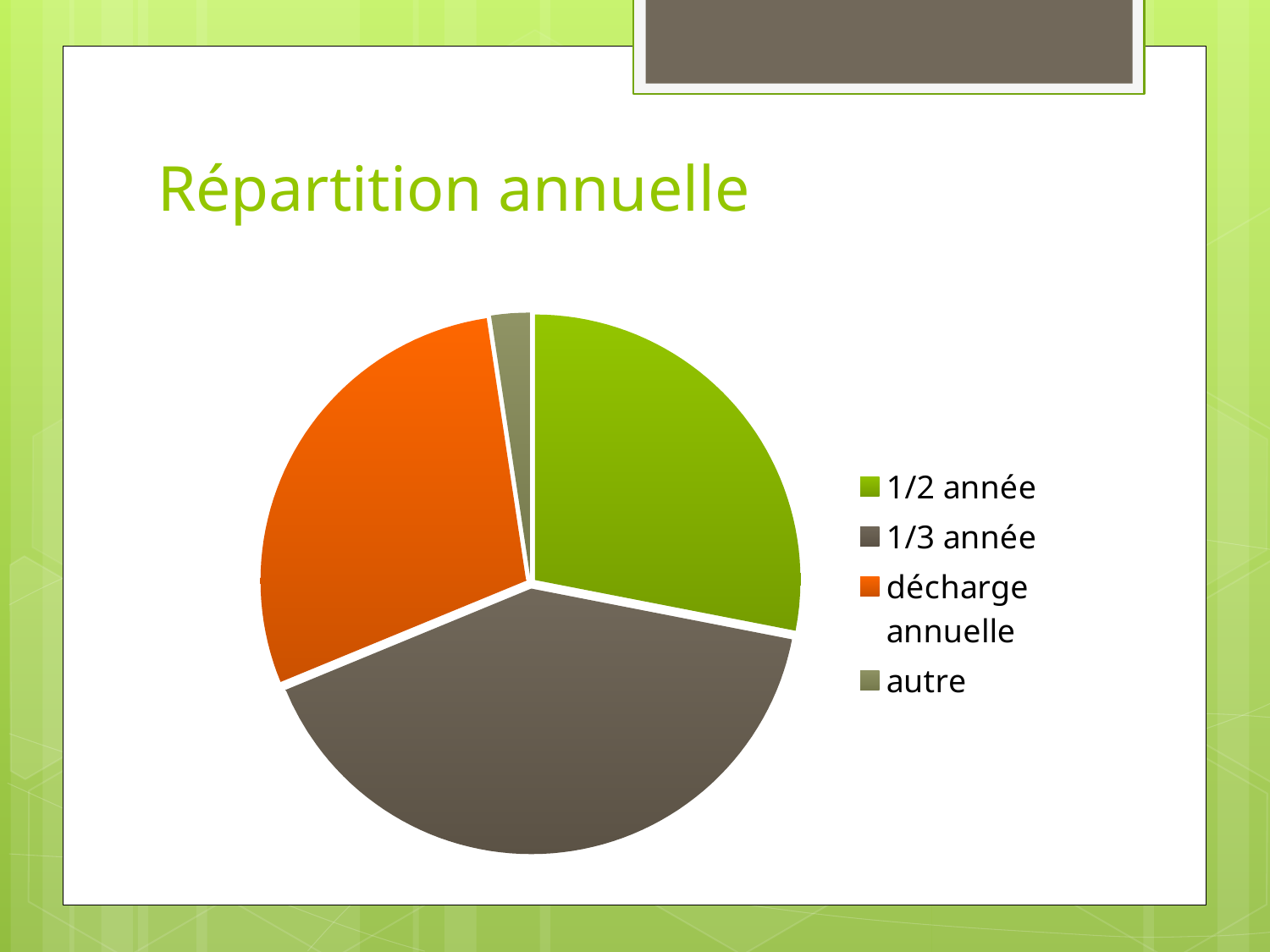
What is the title of the chart? Répartition annuelle Which slice is larger, 1/3 année or 1/2 année? 1/3 année What colour is the slice for décharge annuelle? orange Which category has the largest slice of the pie? 1/3 année How many entries does the legend list? 4 Which slice is larger, décharge annuelle or autre? décharge annuelle What kind of chart is shown on the slide? pie chart Which slice is larger, 1/3 année or autre? 1/3 année How many slices does the pie chart have? 4 Which category has the smallest slice of the pie? autre